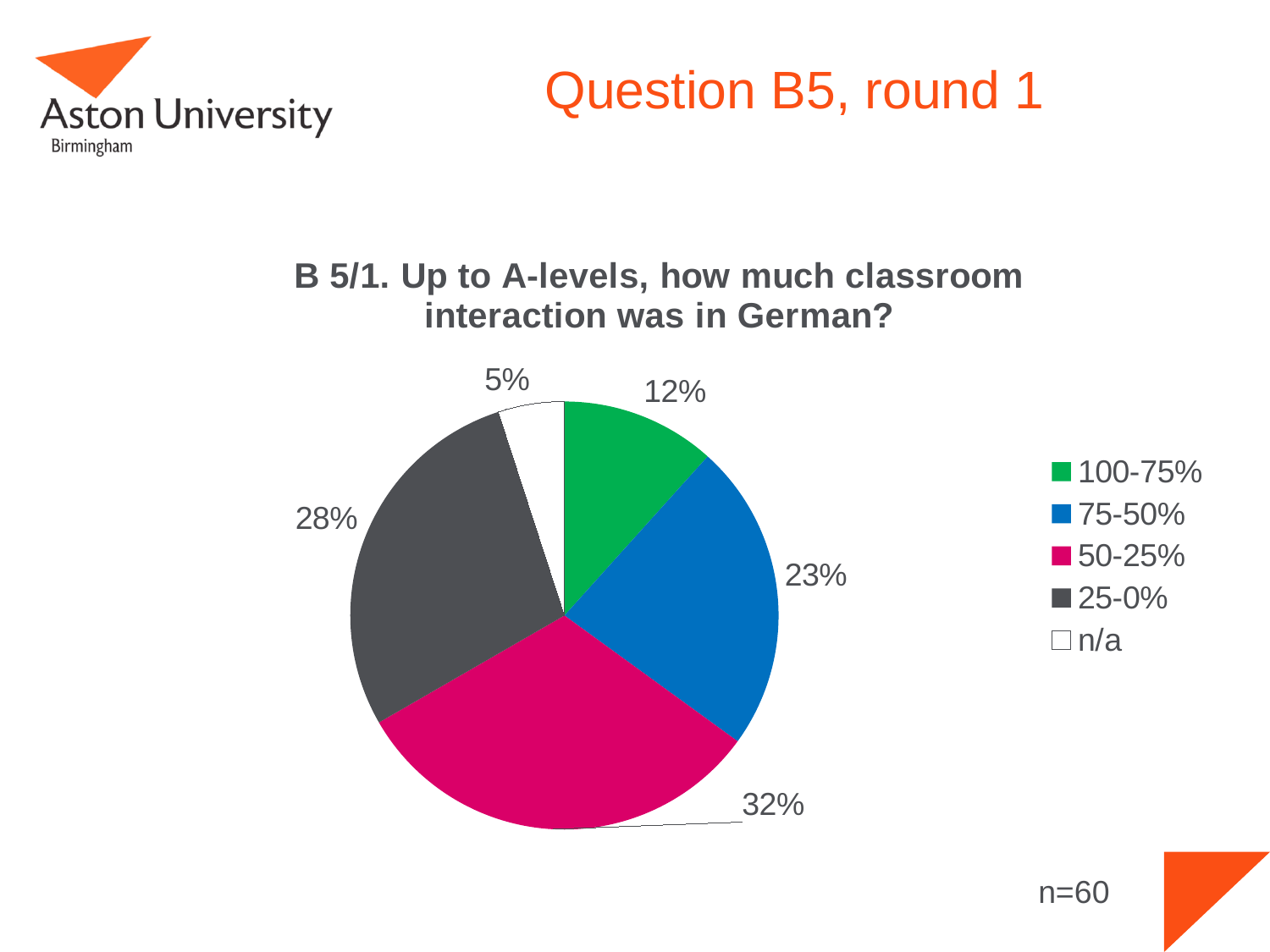
What colour is the 75-50% slice? blue How many categories does the pie chart show? 5 What kind of chart is shown on the slide? pie chart What is the difference in percentage points between the 50-25% slice and the 25-0% slice? 4 What share of the pie does the n/a category have? 5% What share of the pie does the 100-75% category have? 12% What is the title of the chart? B 5/1. Up to A-levels, how much classroom interaction was in German? Which category has the smallest slice of the pie? n/a Which slice is larger, 75-50% or 100-75%? 75-50% What share of the pie does the 50-25% category have? 32% Which category has the largest slice of the pie? 50-25%